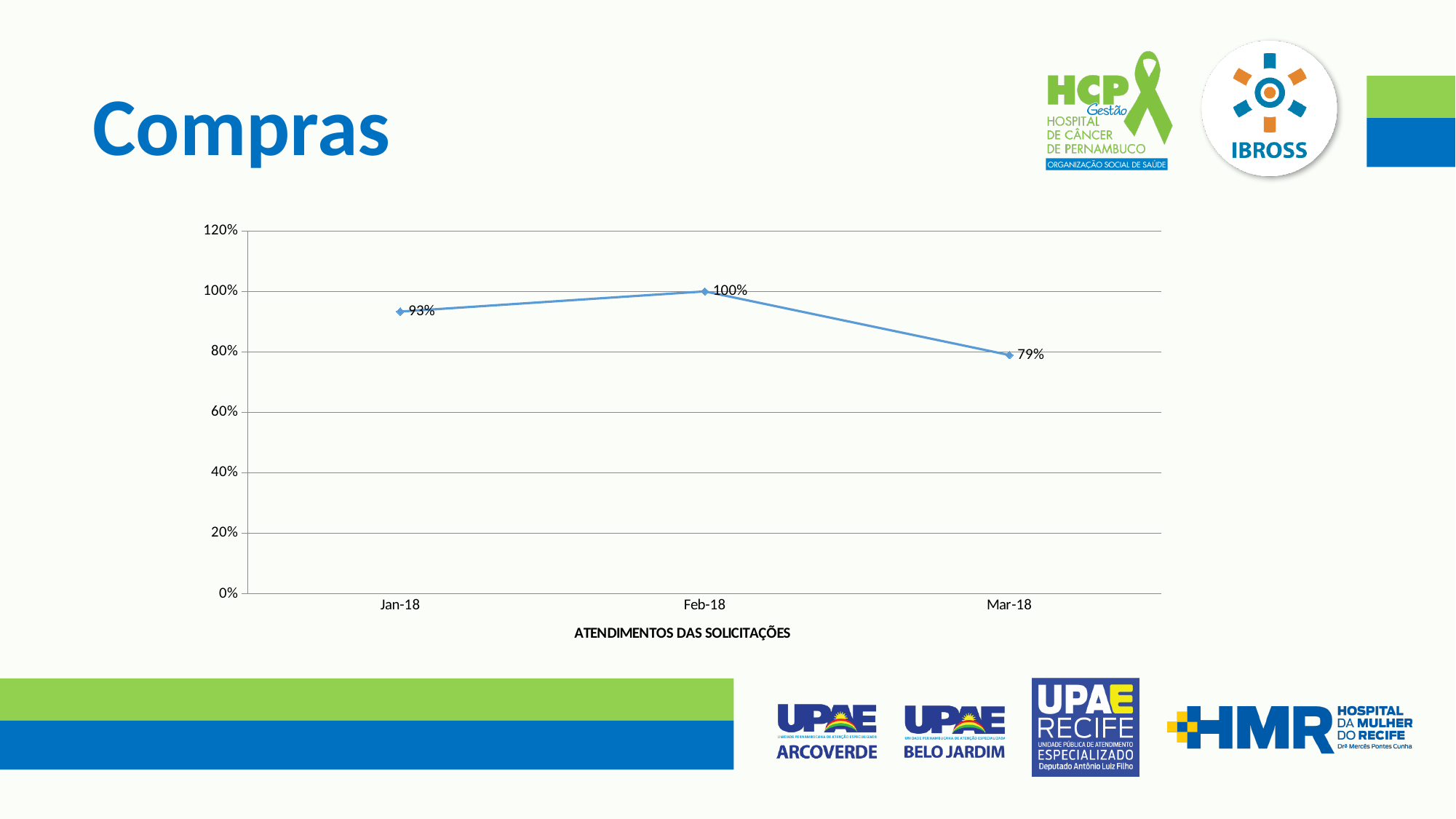
What kind of chart is shown on the slide? line chart What is the difference between the Feb-18 and Jan-18 values? 7% Does the value rise or fall from Feb-18 to Mar-18? fall What is the label shown below the x axis of the chart? ATENDIMENTOS DAS SOLICITAÇÕES What is the value for Feb-18? 100% What is the difference between the Feb-18 and Mar-18 values? 21% What is the value for Mar-18? 79% How many data points are plotted on the chart? 3 Which month has the lowest value? Mar-18 What is the value for Jan-18? 93% Which month has the highest value? Feb-18 Which is larger, the value for Jan-18 or the value for Mar-18? Jan-18